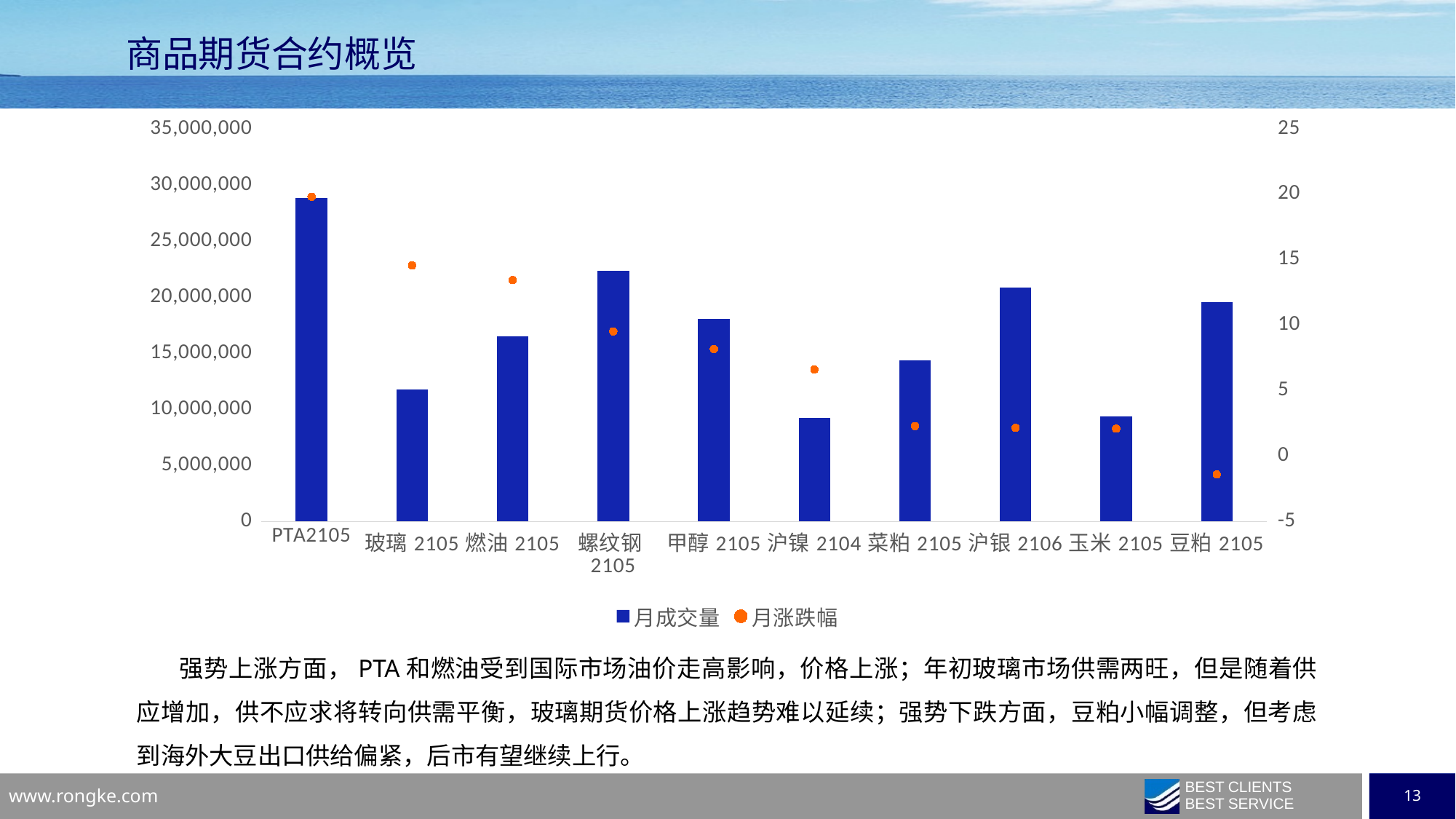
What kind of chart is shown on the slide? A bar chart combined with a dot (scatter) series Is the 月成交量 value for 沪镍 2104 greater or less than 10,000,000? less Which has the larger 月成交量 bar, 螺纹钢 2105 or 甲醇 2105? 螺纹钢 2105 Which category has the highest 月涨跌幅 dot? PTA2105 Which has the larger 月成交量 bar, 沪银 2106 or 菜粕 2105? 沪银 2106 How many series does the chart legend list? 2 Is the 月涨跌幅 value for 豆粕 2105 greater or less than 0? less Which category has the highest 月成交量 bar? PTA2105 Which category has the lowest 月涨跌幅 dot? 豆粕 2105 Is the 月成交量 value for PTA2105 greater or less than 25,000,000? greater What are the two series named in the chart legend? 月成交量 and 月涨跌幅 How many categories are shown on the x axis of the chart? 10